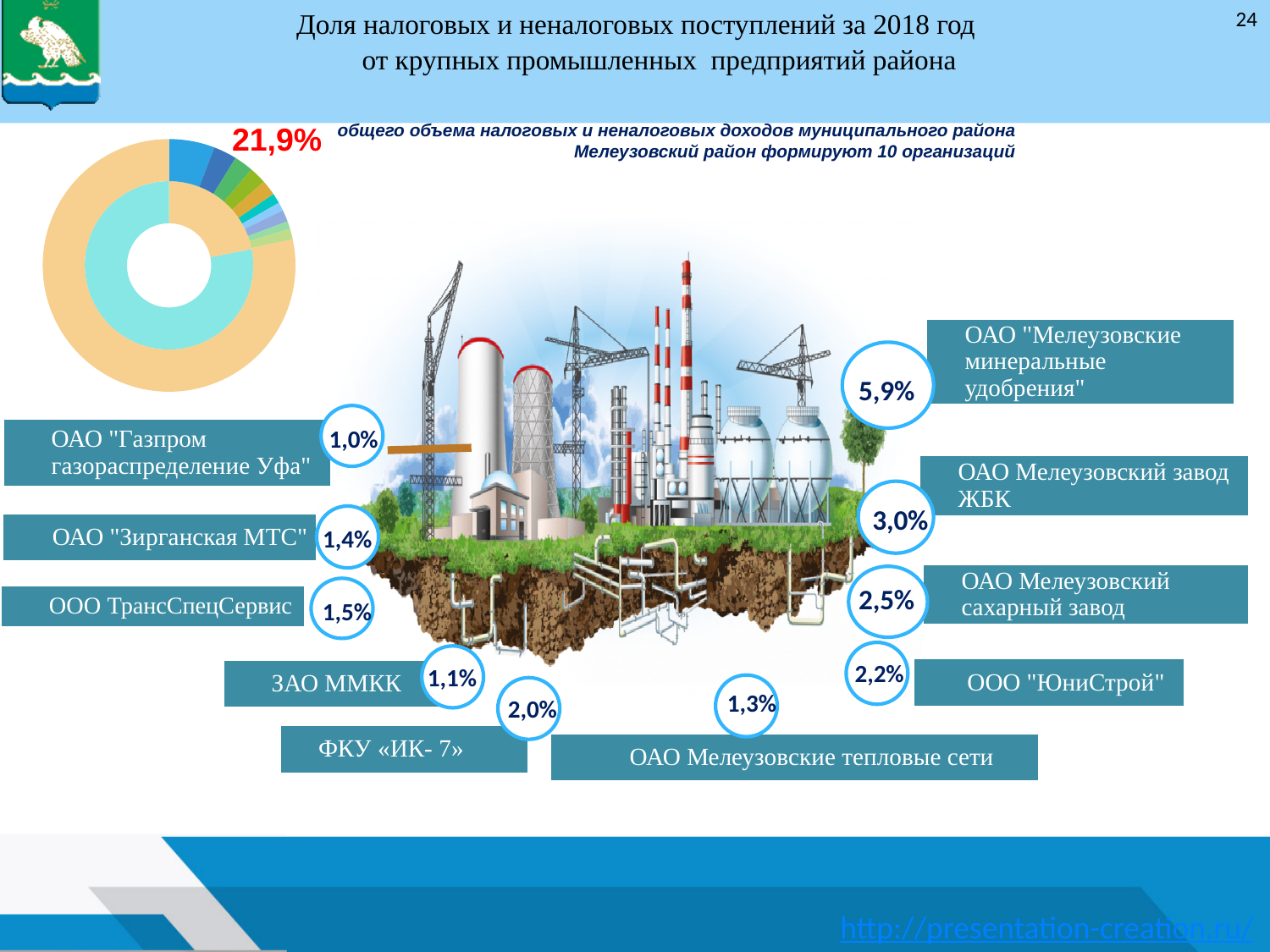
How many organizations are listed with their revenue shares on the slide? 10 Which organization has the largest share of revenue on the slide? ОАО "Мелеузовские минеральные удобрения" Which organization has the smallest share of revenue on the slide? ОАО "Газпром газораспределение Уфа" Which has a larger share: ОАО Мелеузовский завод ЖБК or ОАО Мелеузовский сахарный завод? ОАО Мелеузовский завод ЖБК What share is shown for ОАО Мелеузовский завод ЖБК? 3,0% What share is shown for ФКУ «ИК-7»? 2,0% For which year does the slide show the share of tax and non-tax revenue? 2018 What is the combined share of the 10 organizations in the district's total tax and non-tax revenue? 21,9% What is the difference between the shares of ОАО "Мелеузовские минеральные удобрения" and ОАО Мелеузовский завод ЖБК? 2,9% What share of tax and non-tax revenue is attributed to ОАО "Мелеузовские минеральные удобрения"? 5,9% What share is shown for ОАО Мелеузовские тепловые сети? 1,3% What kind of chart is shown on the slide? pie (donut) chart